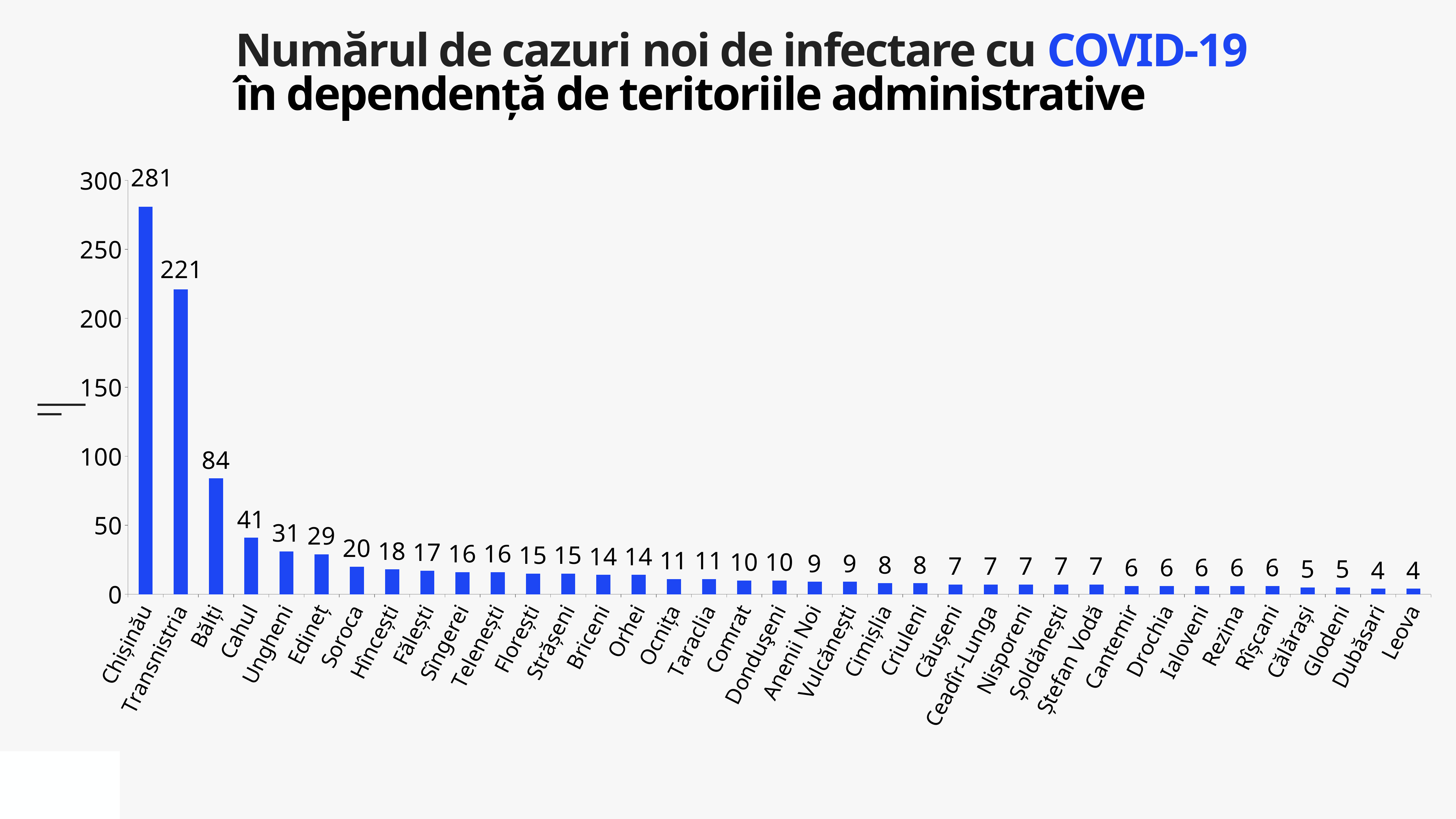
Which is larger, the value for Transnistria or the value for Bălți? Transnistria How many territories are shown on the chart? 37 What is the value for Chișinău? 281 What is the difference between the values for Chișinău and Transnistria? 60 What is the value for Orhei? 14 Is the value for Transnistria greater or less than 200? greater Which territory has the highest number of new cases? Chișinău What kind of chart is shown on the slide? bar chart What is the value for Bălți? 84 What is the value for Soroca? 20 Do the values rise or fall from left to right along the x axis? fall What is the difference between the values for Cahul and Ungheni? 10